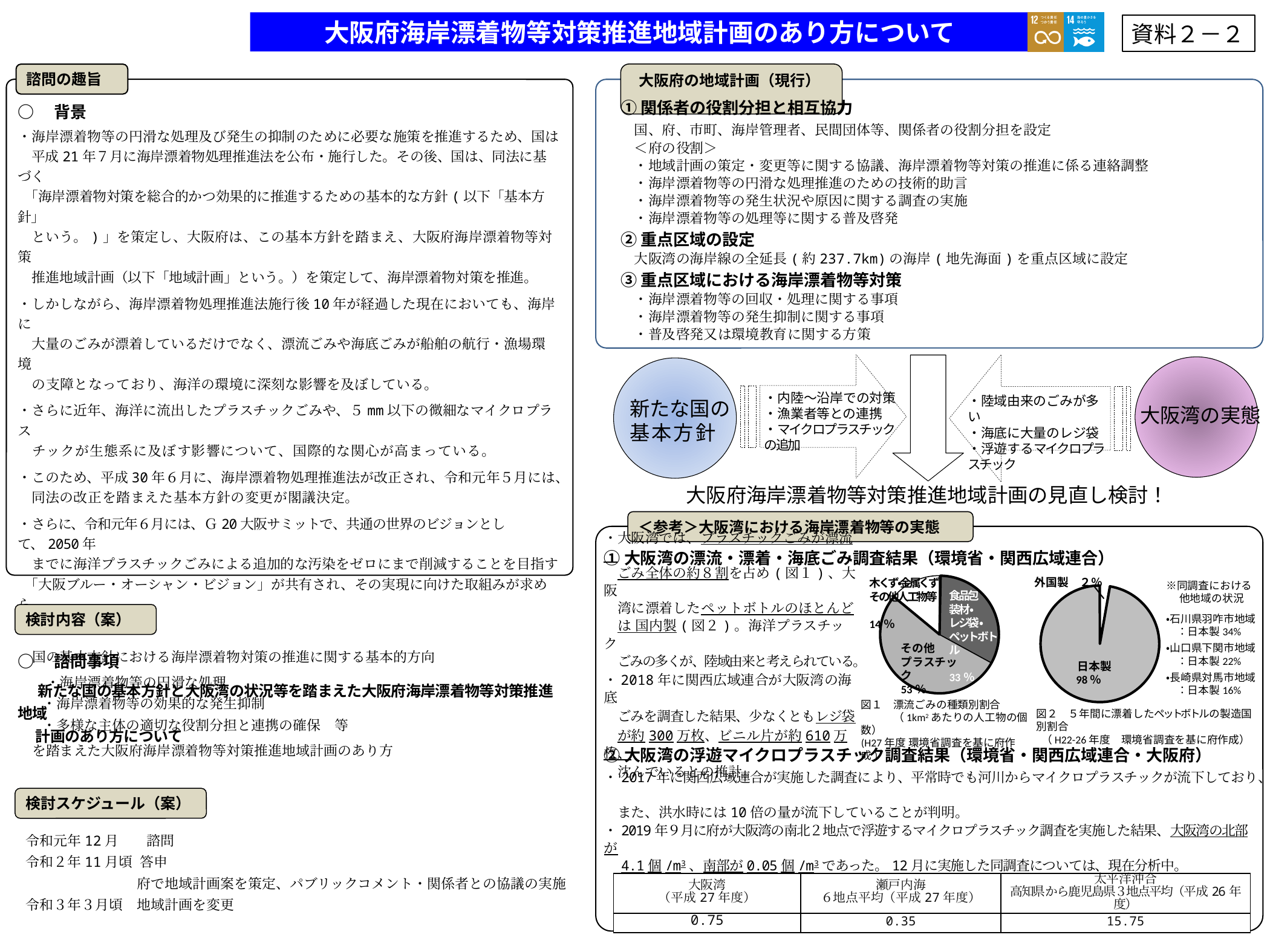
In 図2 (5年間に漂着したペットボトルの製造国別割合), what percentage is shown for 日本製? 98％ What kind of chart is 図1 (漂流ごみの種類別割合)? pie chart In 図1 (漂流ごみの種類別割合), which category has the largest share? その他プラスチック In 図1 (漂流ごみの種類別割合), which category has the smallest share? 木くず金属くずその他人工物等 In 図1 (漂流ごみの種類別割合), what percentage is shown for その他プラスチック? 53％ In 図2 (5年間に漂着したペットボトルの製造国別割合), which is larger, 日本製 or 外国製? 日本製 In 図1 (漂流ごみの種類別割合), what percentage is shown for 木くず金属くずその他人工物等? 14％ In 図2 (5年間に漂着したペットボトルの製造国別割合), what percentage is shown for 外国製? 2％ In 図1 (漂流ごみの種類別割合), how many slices does the pie chart have? 3 In 図1 (漂流ごみの種類別割合), what percentage is shown for 食品包装材・レジ袋・ペットボトル? 33％ In 図2 (5年間に漂着したペットボトルの製造国別割合), how many slices does the pie chart have? 2 In 図1 (漂流ごみの種類別割合), what is the difference in percentage points between その他プラスチック and 食品包装材・レジ袋・ペットボトル? 20